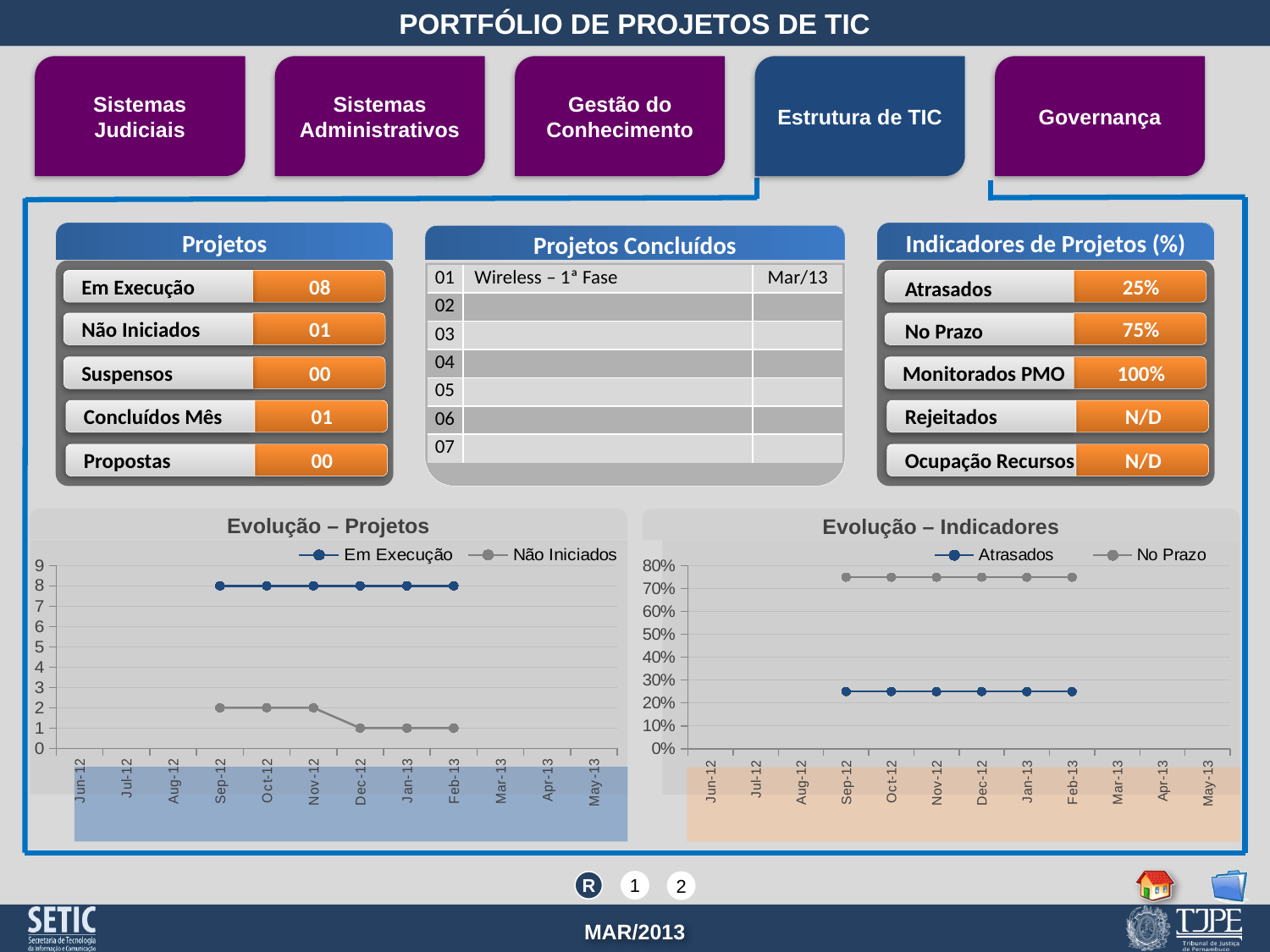
In the 'Evolução – Projetos' chart, does the Não Iniciados series rise or fall from Sep-12 to Feb-13? fall In the 'Evolução – Indicadores' chart, is the value for Atrasados in Jan-13 greater or less than 40%? less In the 'Evolução – Indicadores' chart, which series is higher in Dec-12, Atrasados or No Prazo? No Prazo In the 'Evolução – Projetos' chart, what is the value of Em Execução in Feb-13? 8 In the 'Evolução – Projetos' chart, how many series does the legend list? 2 In the 'Evolução – Projetos' chart, which series is higher in Oct-12, Em Execução or Não Iniciados? Em Execução In the 'Evolução – Indicadores' chart, is the value for No Prazo in Nov-12 greater or less than 50%? greater What kind of chart is the 'Evolução – Projetos' chart? line chart In the 'Evolução – Projetos' chart, what is the value of Não Iniciados in Sep-12? 2 What kind of chart is the 'Evolução – Indicadores' chart? line chart In the 'Evolução – Projetos' chart, what is the difference between Em Execução and Não Iniciados in Dec-12? 7 In the 'Evolução – Projetos' chart, what is the value of Não Iniciados in Jan-13? 1